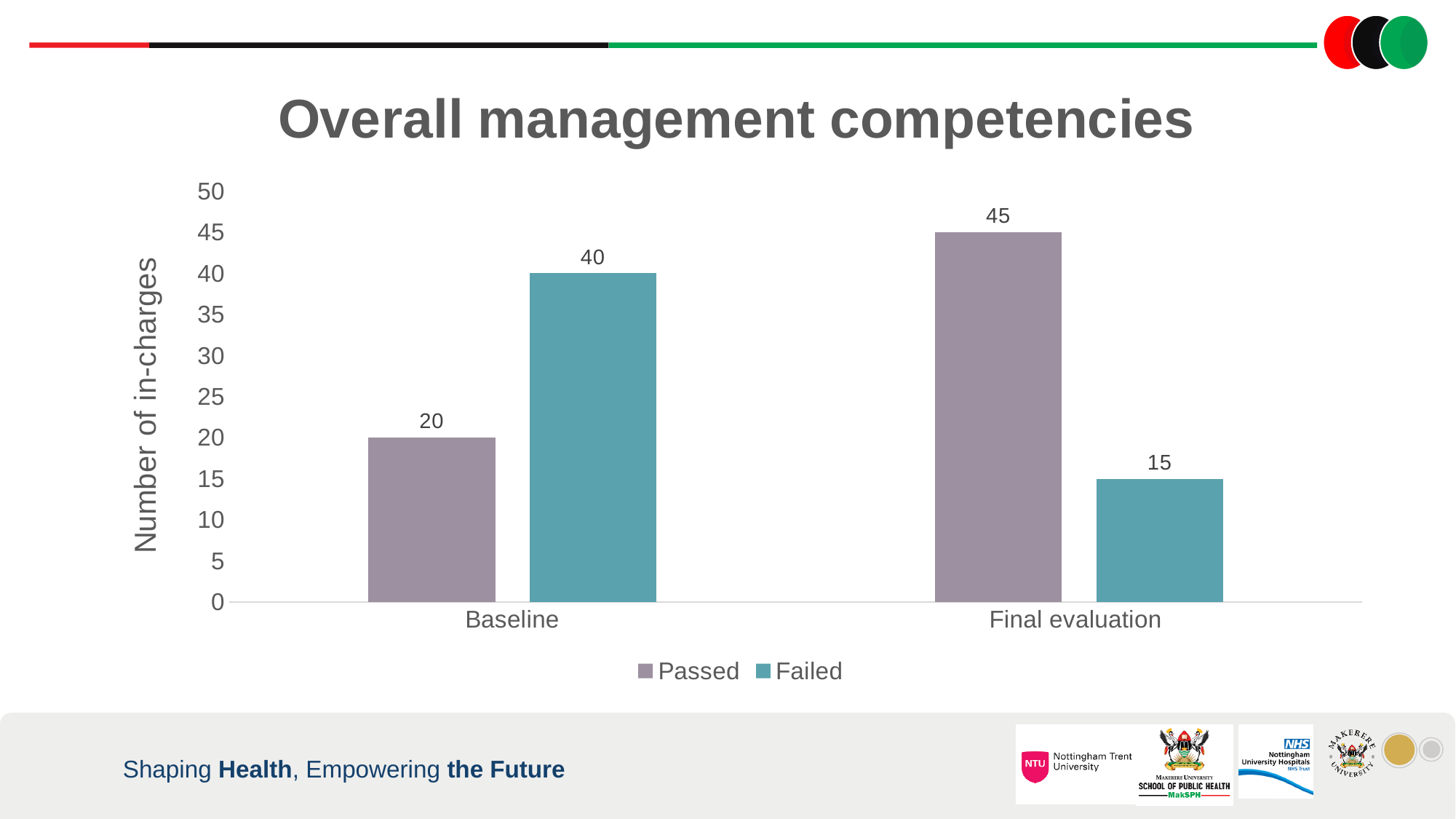
Which is larger at Baseline, Passed or Failed? Failed How many in-charges passed at Baseline? 20 Which bar has the lowest value on the chart? Failed at Final evaluation What is the label of the y axis? Number of in-charges What is the difference between Passed at Final evaluation and Passed at Baseline? 25 What kind of chart is shown on the slide? Bar chart What is the value for Passed at Final evaluation? 45 Which bar has the highest value on the chart? Passed at Final evaluation How many categories are shown on the x axis? 2 How many series does the legend list? 2 How many in-charges failed at Final evaluation? 15 What is the value for Failed at Baseline? 40